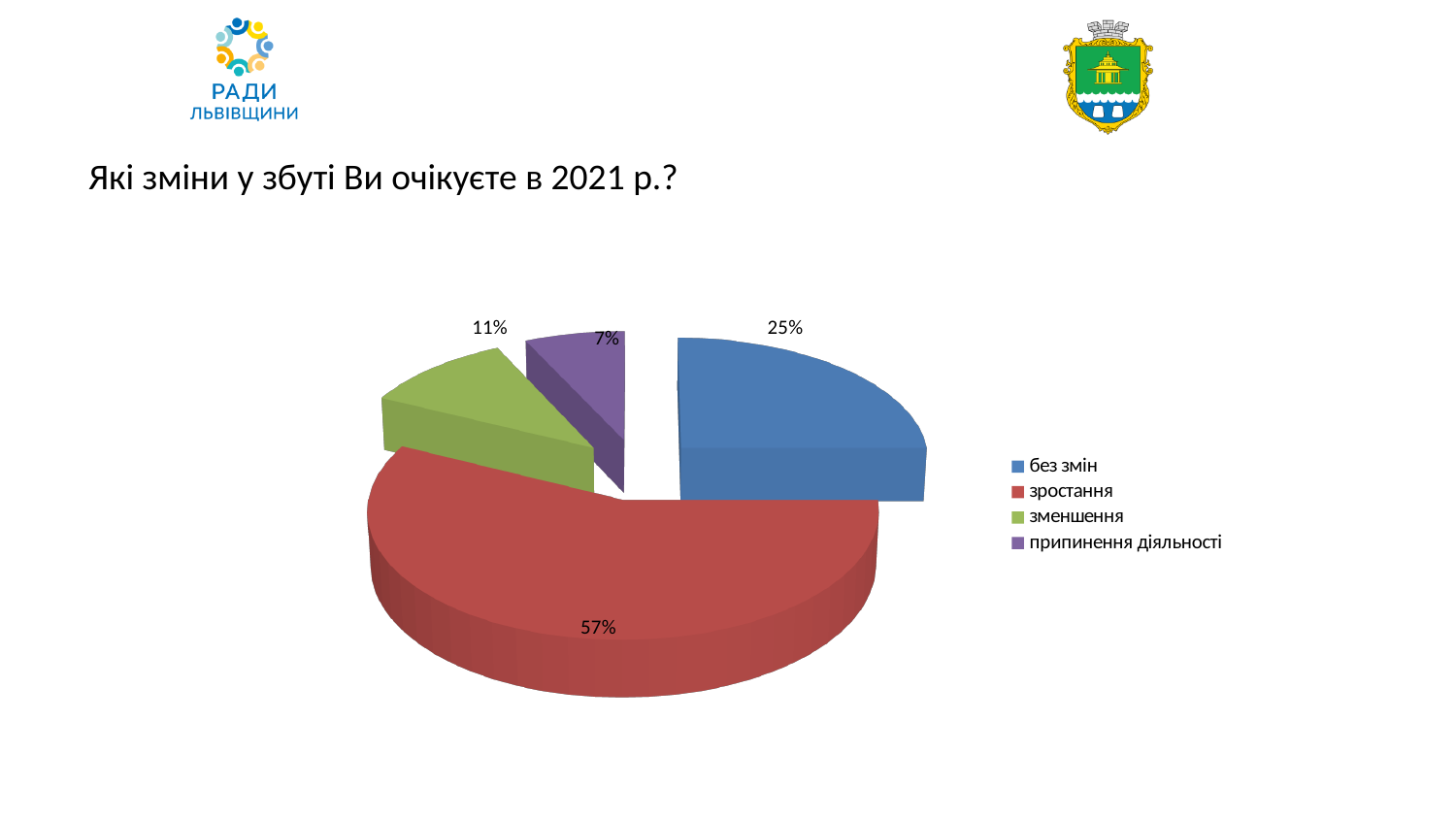
What is the title of the slide above the chart? Які зміни у збуті Ви очікуєте в 2021 р.? Which category has the largest slice of the pie? зростання What colour is the slice for "зменшення"? green What share of the pie does "зменшення" have? 11% What share of the pie does "без змін" have? 25% How many categories does the pie chart have? 4 What share of the pie does "припинення діяльності" have? 7% Which category has the smallest slice of the pie? припинення діяльності Which is larger, the share for "зменшення" or the share for "припинення діяльності"? зменшення What is the difference in percentage points between "зростання" and "без змін"? 32 What kind of chart is shown on the slide? pie chart